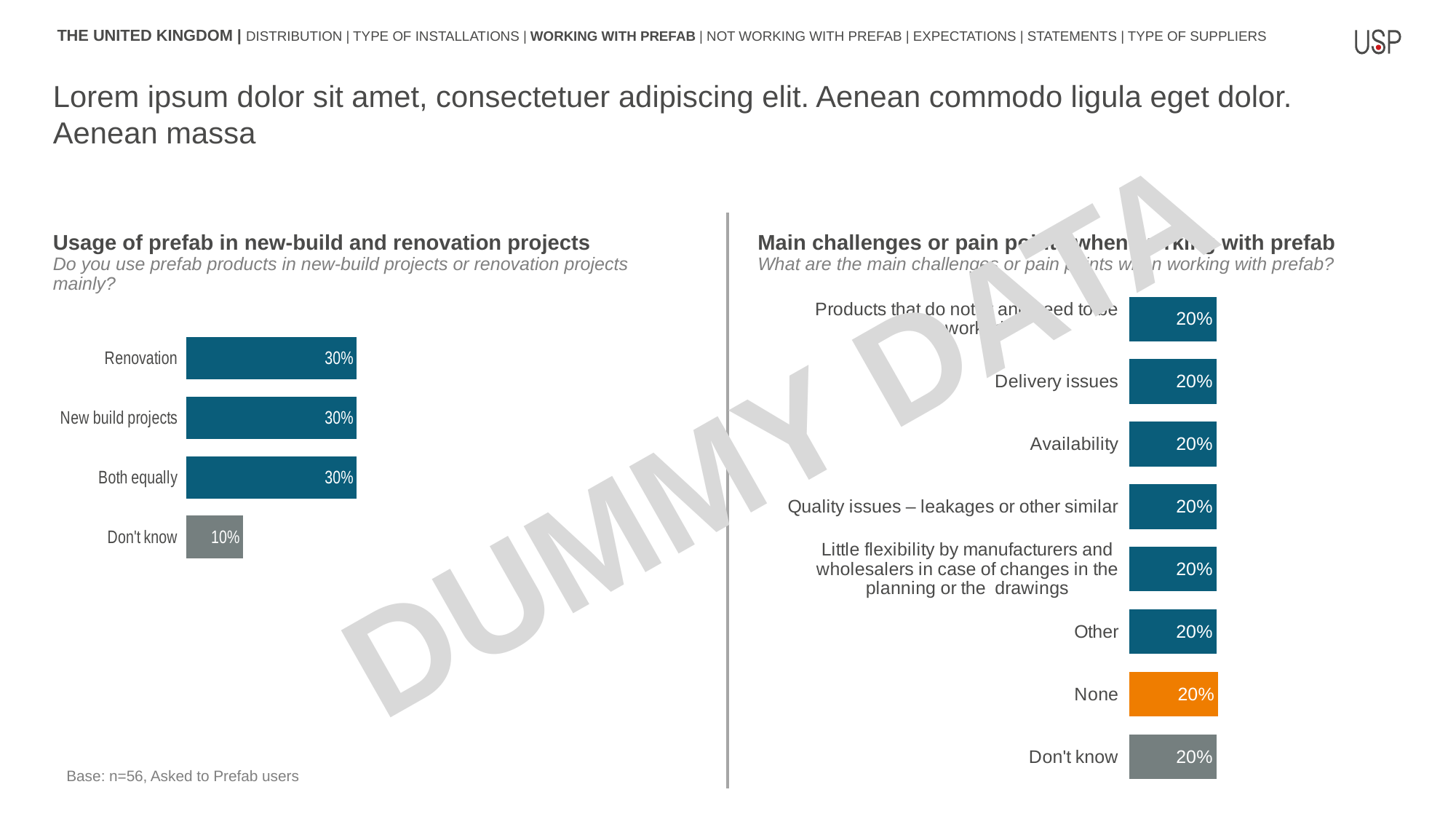
In the 'Usage of prefab in new-build and renovation projects' chart, what is the difference between the values for New build projects and Don't know? 20% In the 'Usage of prefab in new-build and renovation projects' chart, what is the value for Renovation? 30% In the 'Main challenges or pain points when working with prefab' chart, what is the value for Availability? 20% How many categories are shown in the 'Main challenges or pain points when working with prefab' chart? 8 In the 'Main challenges or pain points when working with prefab' chart, what is the value for None? 20% In the 'Usage of prefab in new-build and renovation projects' chart, what is the value for Don't know? 10% What kind of chart is the 'Usage of prefab in new-build and renovation projects' chart? Bar chart In the 'Main challenges or pain points when working with prefab' chart, what is the value for Delivery issues? 20% How many categories are shown in the 'Usage of prefab in new-build and renovation projects' chart? 4 In the 'Main challenges or pain points when working with prefab' chart, which category's bar is coloured orange? None In the 'Usage of prefab in new-build and renovation projects' chart, which is larger: Both equally or Don't know? Both equally In the 'Usage of prefab in new-build and renovation projects' chart, which category has the lowest value? Don't know